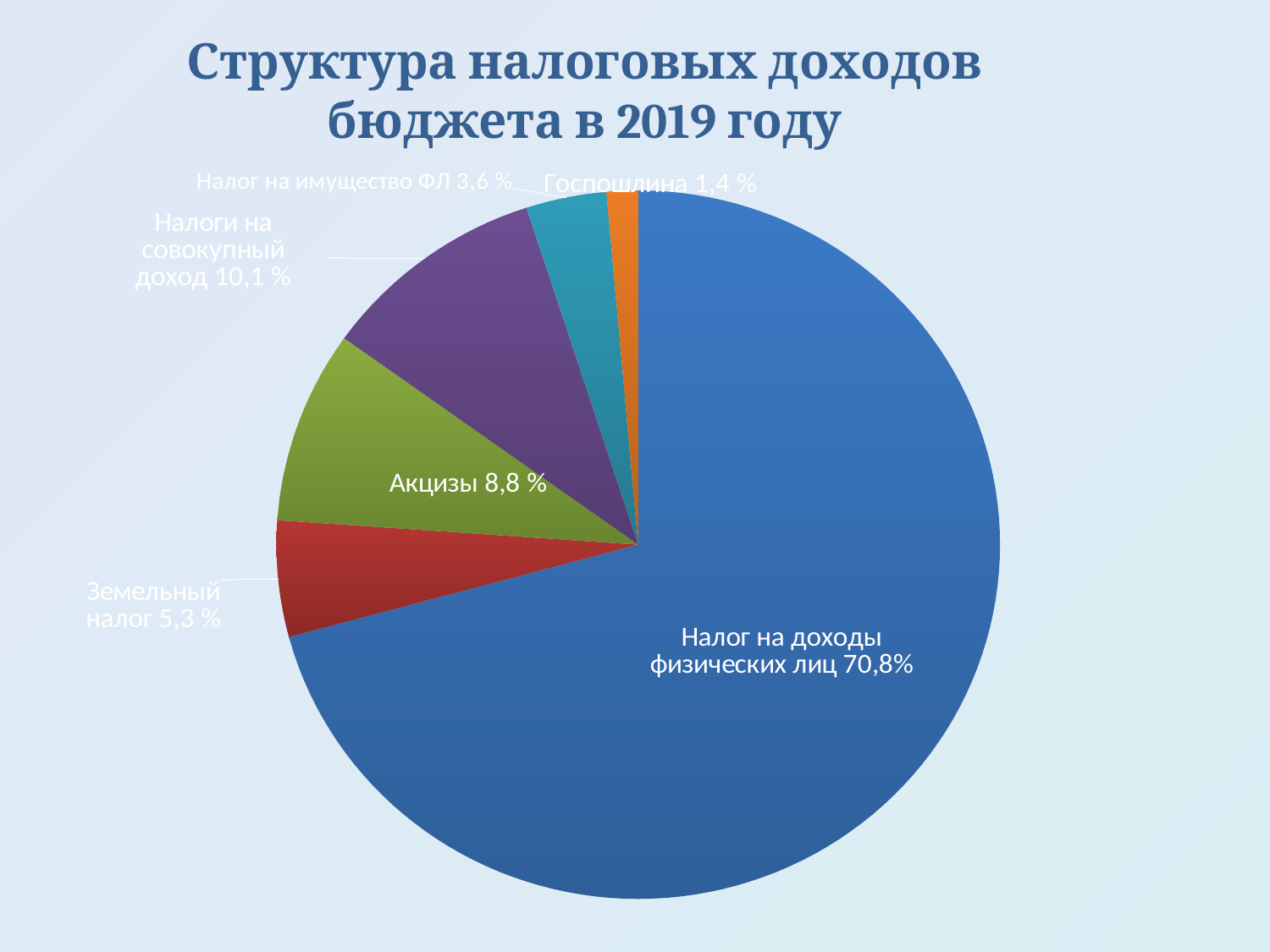
Which category has the largest slice of the pie? Налог на доходы физических лиц What is the value shown for Госпошлина? 1,4 % What is the value shown for Земельный налог? 5,3 % What is the difference between the values for Налоги на совокупный доход and Земельный налог? 4,8 % Which is larger, Акцизы or Налог на имущество ФЛ? Акцизы What share of the pie is Налог на доходы физических лиц? 70,8% What type of chart is shown on the slide? pie chart What is the value shown for Акцизы? 8,8 % Which category has the smallest slice of the pie? Госпошлина What is the value shown for Налоги на совокупный доход? 10,1 % What is the title of the chart? Структура налоговых доходов бюджета в 2019 году How many slices does the pie chart have? 6